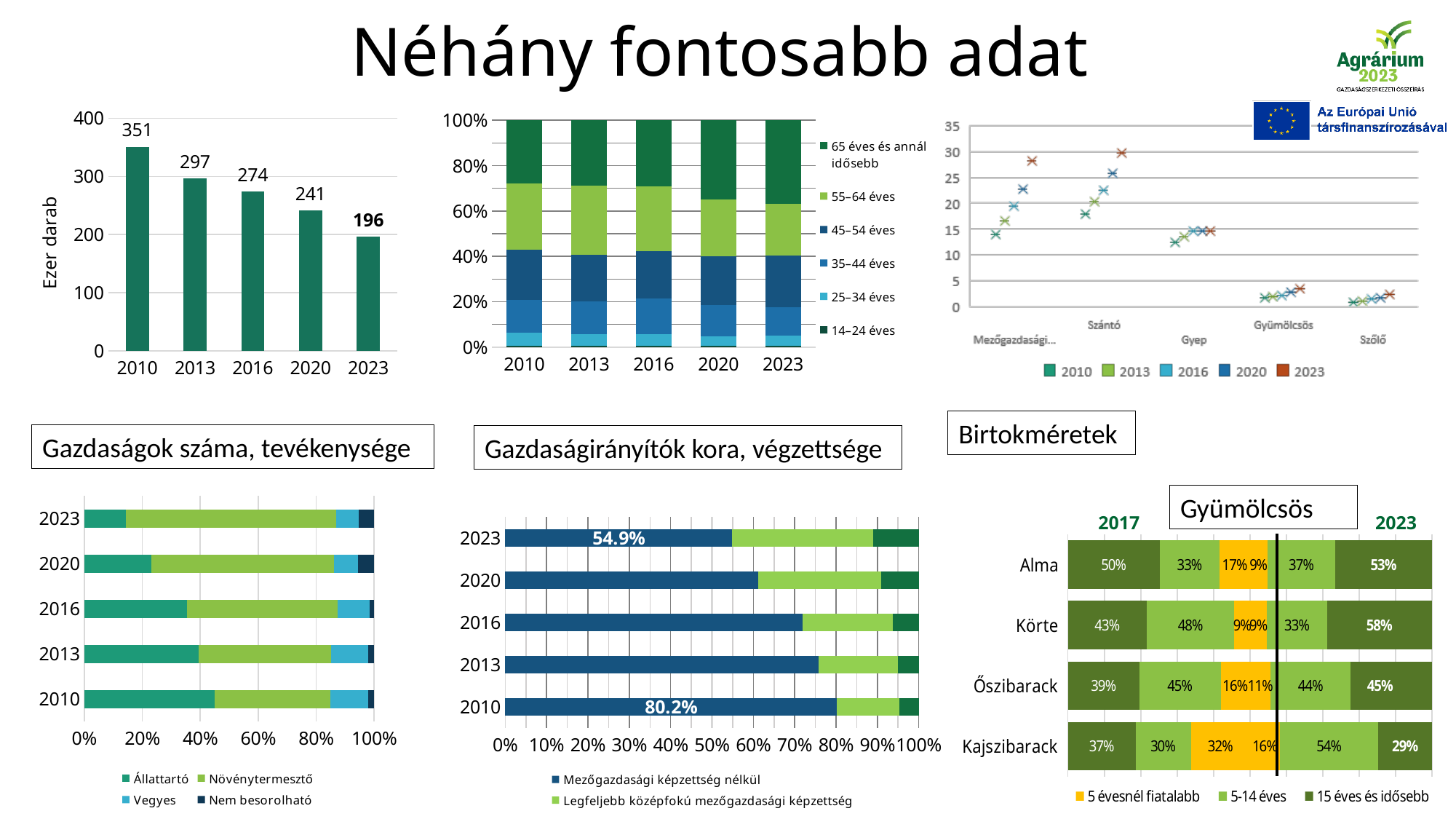
In the Gyümölcsös chart (bottom right), what is the 2023 share of '15 éves és idősebb' for Körte? 58% In the top-left bar chart (Ezer darab), what is the value for 2010? 351 In the bottom-middle chart (Gazdaságirányítók végzettsége), what is the labelled share of 'Mezőgazdasági képzettség nélkül' for 2010? 80.2% In the top-left bar chart (Ezer darab), do the values rise or fall from 2010 to 2023? fall In the top-left bar chart (Ezer darab), what is the difference between the 2010 and 2023 values? 155 In the Gyümölcsös chart (bottom right), which is larger for Alma: the 2017 or the 2023 share of '15 éves és idősebb'? 2023 (53%) In the top-left bar chart (Ezer darab), which year has the lowest value? 2023 How many series does the legend of the top-middle stacked bar chart (age groups) list? 6 In the bottom-middle chart (Gazdaságirányítók végzettsége), what is the labelled share of 'Mezőgazdasági képzettség nélkül' for 2023? 54.9% How many series does the legend of the bottom-left chart (Állattartó, Növénytermesztő, ...) list? 4 In the top-left bar chart (Ezer darab), what is the value for 2023? 196 How many series does the legend of the Birtokméretek chart (top right) list? 5